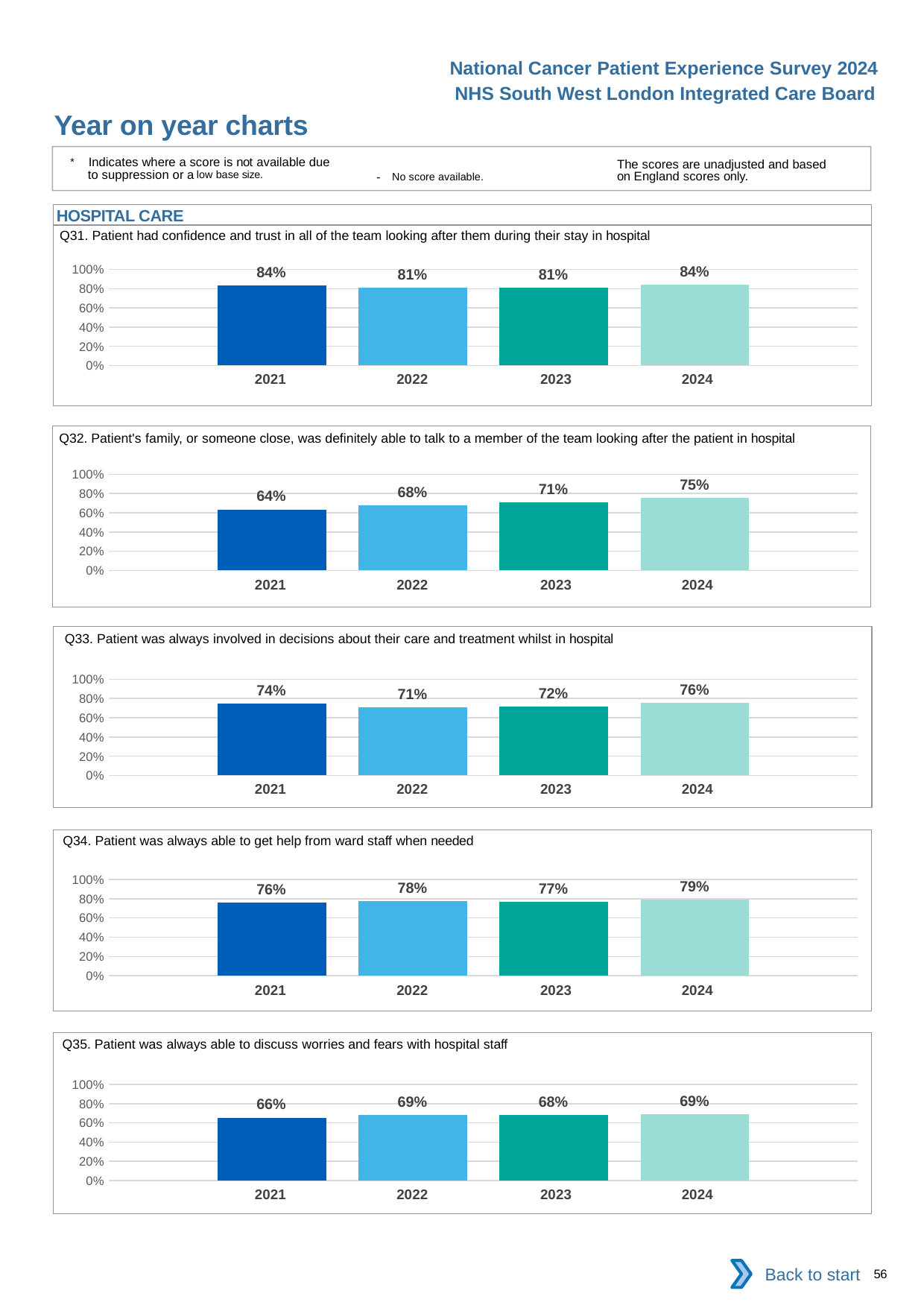
In the Q31 chart, what is the value for 2022? 81% In the Q32 chart, what is the difference between the 2024 and 2021 values? 11% In the Q33 chart, which is larger, the value for 2021 or the value for 2022? 2021 In the Q34 chart, what is the value for 2023? 77% How many years are shown on the x axis of the Q31 chart? 4 In the Q34 chart, is the value for 2021 greater or less than 60%? greater In the Q33 chart, what is the value for 2024? 76% In the Q32 chart, which year has the lowest value? 2021 In the Q32 chart, which year has the highest value? 2024 In the Q35 chart, what is the difference between the 2022 and 2023 values? 1% What kind of chart is the Q34 chart? Bar chart In the Q35 chart, what is the value for 2021? 66%